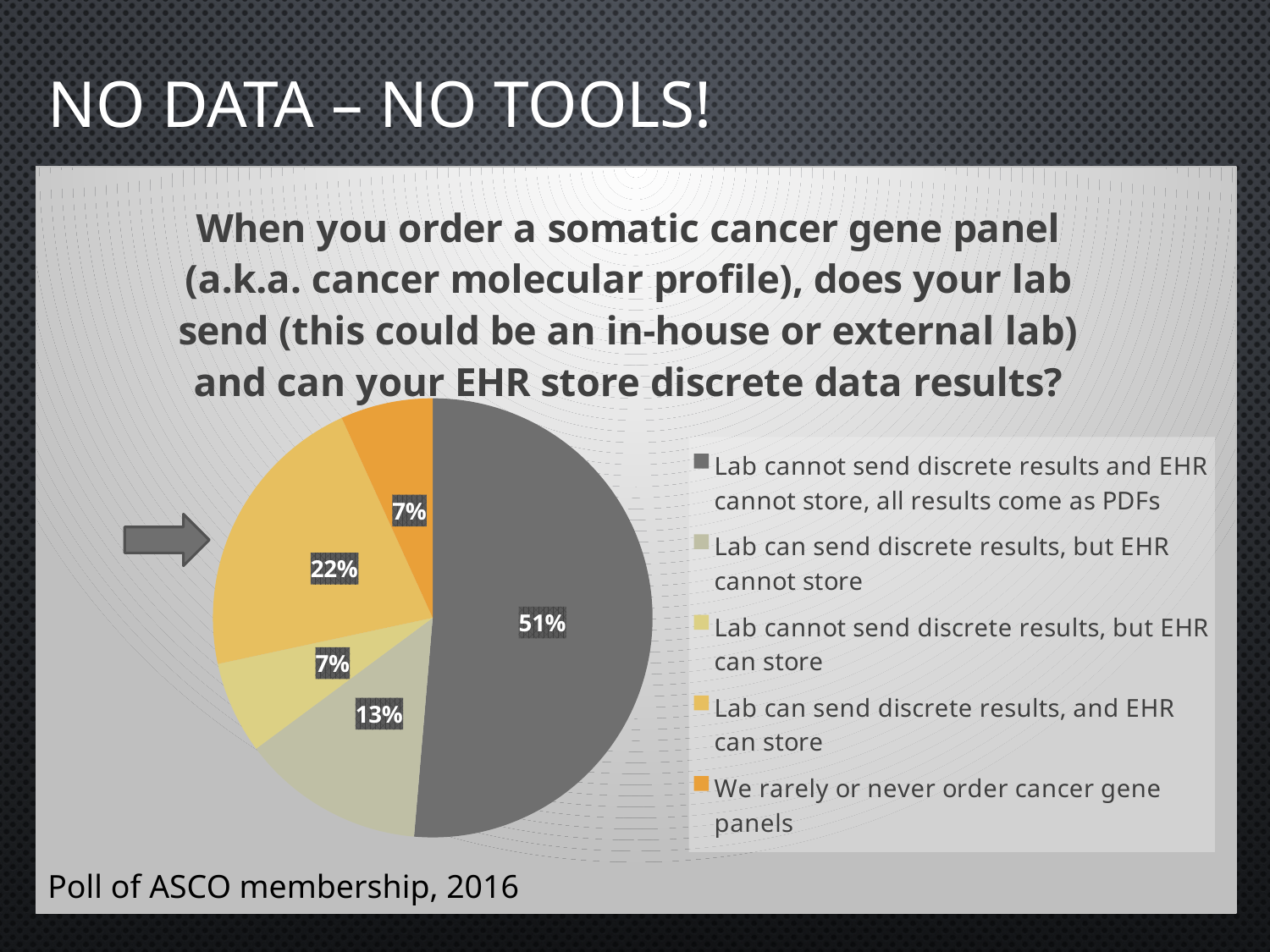
Which response has the largest share of the pie? Lab cannot send discrete results and EHR cannot store, all results come as PDFs What share of respondents said their lab can send discrete results, and EHR can store? 22% What share of respondents said they rarely or never order cancer gene panels? 7% How many entries does the legend list? 5 How many categories does the pie chart have? 5 What is the difference in percentage points between 'Lab cannot send discrete results and EHR cannot store' and 'Lab can send discrete results, and EHR can store'? 29 percentage points What share of respondents said their lab can send discrete results, but EHR cannot store? 13% What kind of chart is shown on the slide? pie chart What share of respondents said their lab cannot send discrete results and EHR cannot store, all results come as PDFs? 51% Which is larger: the share for 'Lab can send discrete results, but EHR cannot store' or the share for 'Lab can send discrete results, and EHR can store'? Lab can send discrete results, and EHR can store According to the caption, what is the source of the data in the pie chart? Poll of ASCO membership, 2016 What share of respondents said their lab cannot send discrete results, but EHR can store? 7%